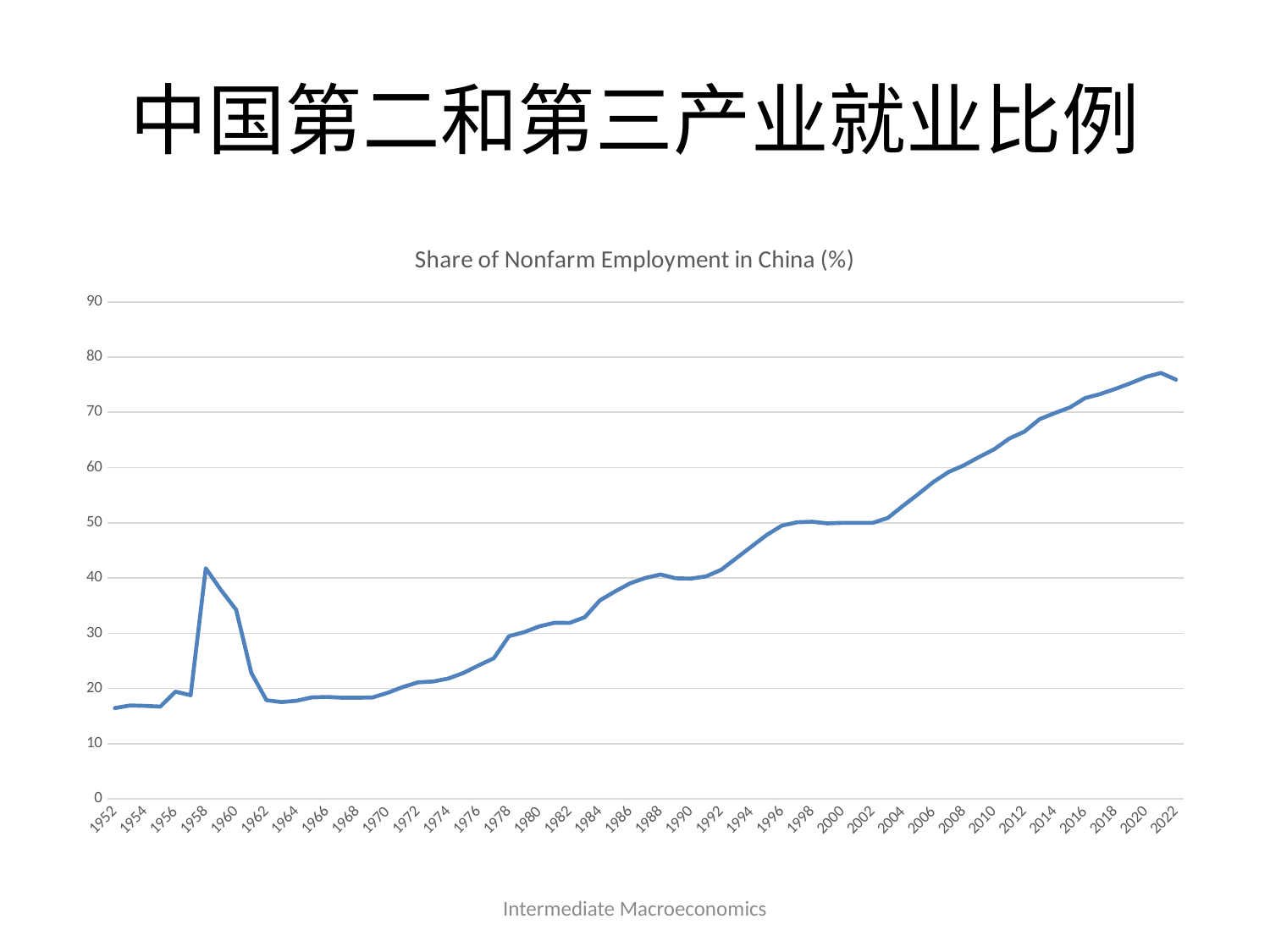
Which year has the larger value, 1952 or 2022? 2022 How many lines are plotted on the chart? 1 Is the value for 2010 greater or less than 60? greater Is the value for 1952 greater or less than 20? less Overall, does the share of nonfarm employment rise or fall from 1952 to 2022? rise What kind of chart is shown on the slide? line chart Is the value for 2022 greater or less than 70? greater What is the title of the chart? Share of Nonfarm Employment in China (%) Which year has the larger value, 1958 or 1962? 1958